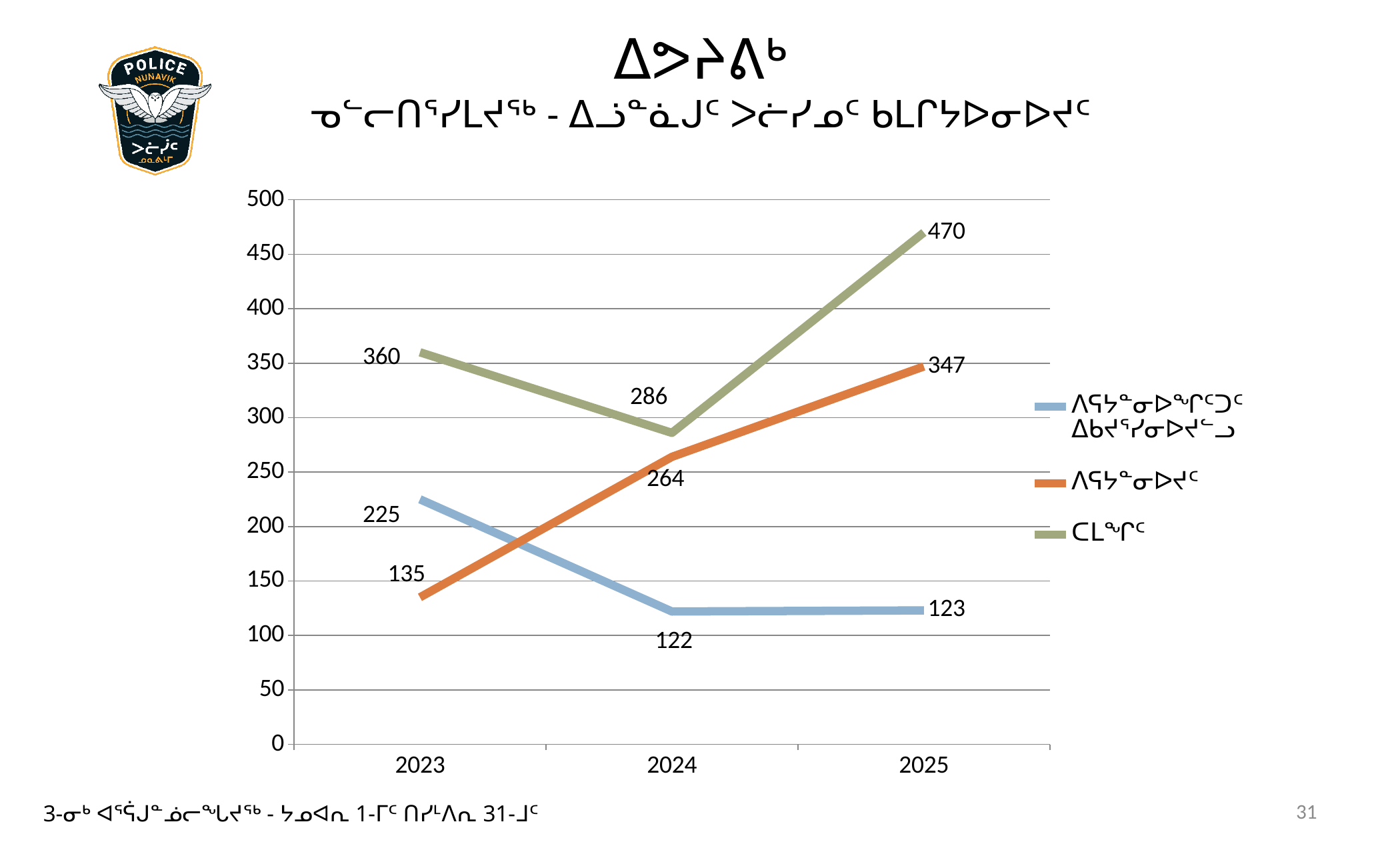
What is the value of the blue line (first legend entry) in 2023? 225 What is the difference between the green line's 2025 value and its 2024 value? 184 In 2023, which is larger: the blue line's value or the orange line's value? the blue line (225) What is the value of the orange line (second legend entry) in 2024? 264 In which year does the green line (third legend entry) reach its highest value? 2025 Does the orange line (second legend entry) rise or fall from 2023 to 2025? rise What type of chart is shown on the slide? line chart How many years are shown on the x axis of the chart? 3 How many series does the chart's legend list? 3 By how much did the orange line (second legend entry) increase from 2023 to 2025? 212 In which year does the blue line (first legend entry) have its lowest value? 2024 What is the value of the green line (third legend entry) in 2025? 470